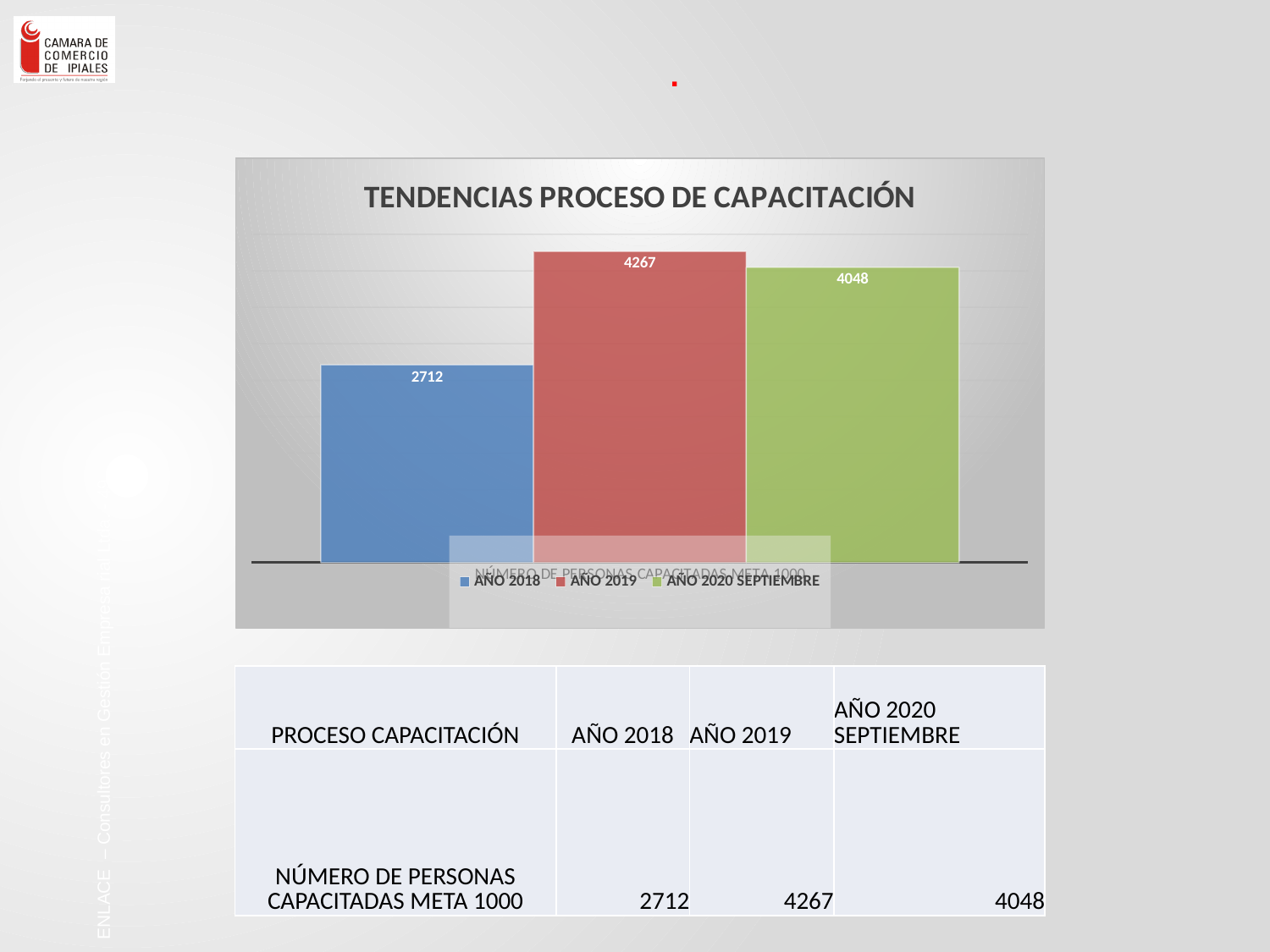
What is the difference between the values for AÑO 2019 and AÑO 2020 SEPTIEMBRE? 219 What is the title of the chart? TENDENCIAS PROCESO DE CAPACITACIÓN Which is larger, the value for AÑO 2018 or the value for AÑO 2020 SEPTIEMBRE? AÑO 2020 SEPTIEMBRE How many series does the legend list? 3 What is the value for AÑO 2019? 4267 How many bars are plotted in the chart? 3 Which series has the highest value? AÑO 2019 Which series has the lowest value? AÑO 2018 What is the value for AÑO 2020 SEPTIEMBRE? 4048 What kind of chart is shown on the slide? bar chart What is the value for AÑO 2018? 2712 What is the difference between the values for AÑO 2019 and AÑO 2018? 1555